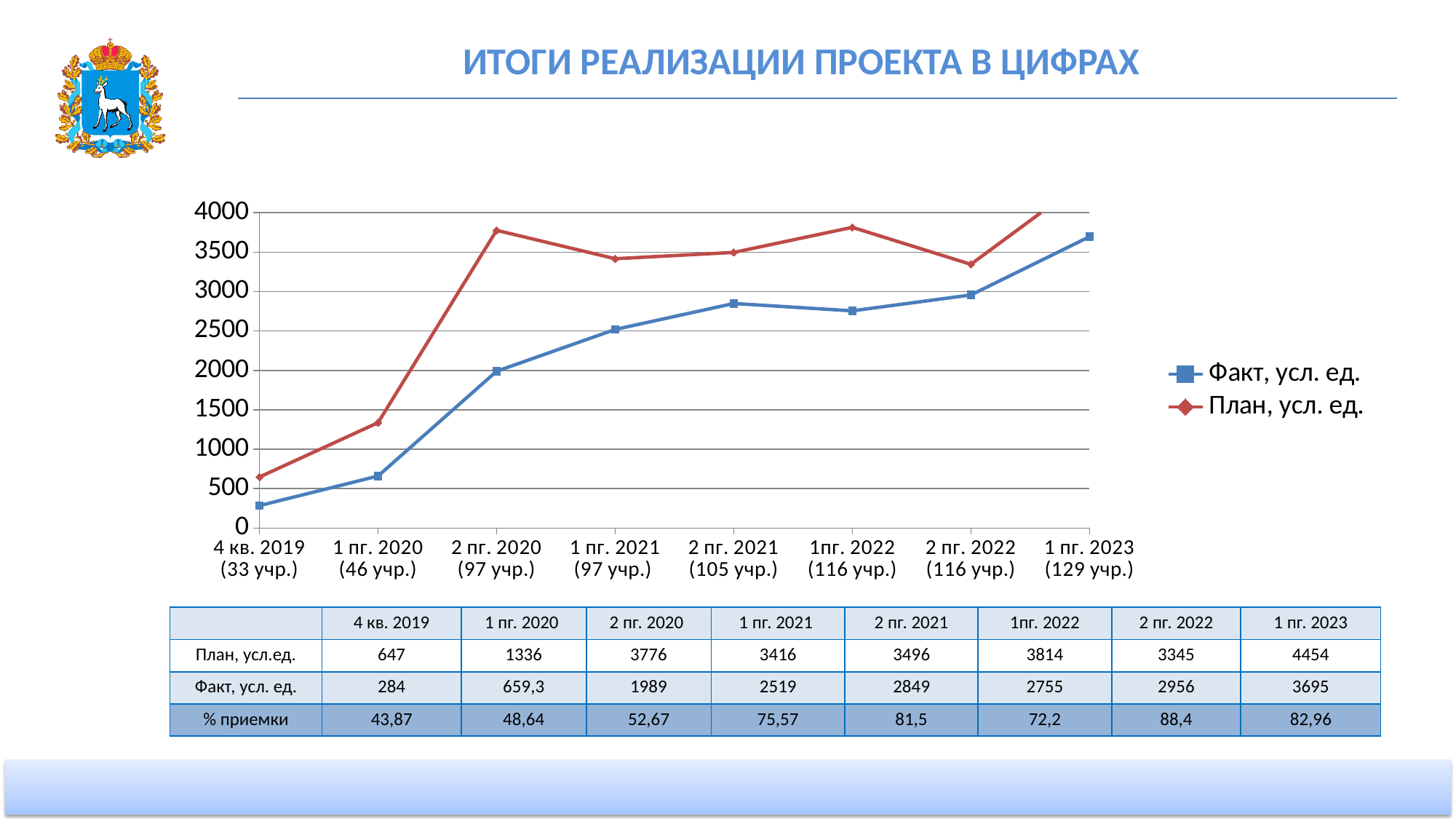
What is the value of План, усл. ед. for 2 пг. 2020? 3776 What kind of chart is shown on the slide? Line chart Is the value of Факт, усл. ед. for 2 пг. 2021 greater or less than 3000? less Which series is drawn with the red line in the chart? План, усл. ед. In which period is План, усл. ед. lowest? 4 кв. 2019 How many series does the chart legend list? 2 Does Факт, усл. ед. rise or fall from 4 кв. 2019 to 2 пг. 2020? rise What is the difference between План, усл. ед. and Факт, усл. ед. for 1 пг. 2021? 897 In which period is Факт, усл. ед. highest? 1 пг. 2023 What is the value of Факт, усл. ед. for 1 пг. 2023? 3695 For 1пг. 2022, which is larger: План, усл. ед. or Факт, усл. ед.? План, усл. ед. How many periods are plotted along the x axis of the chart? 8